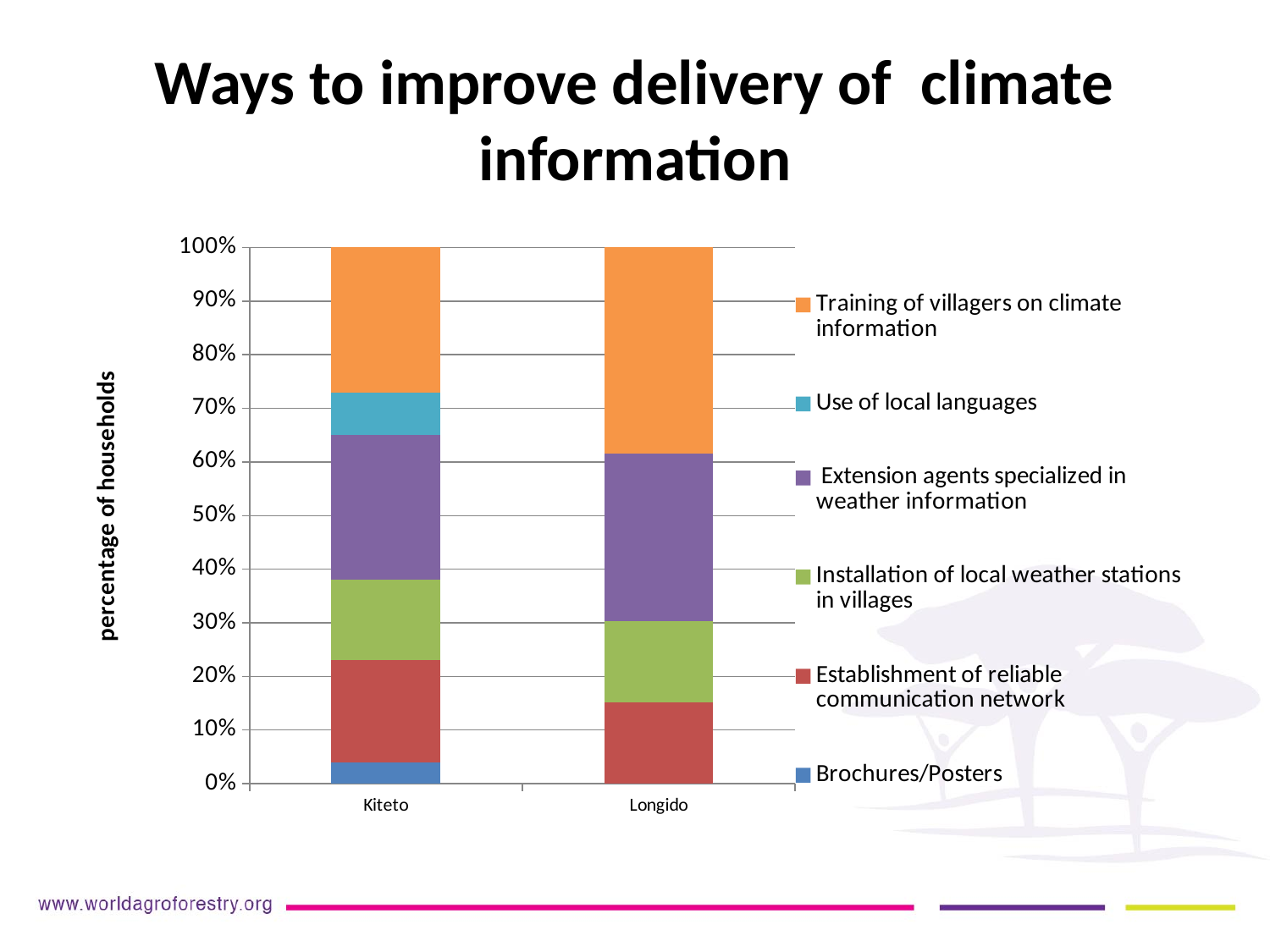
Is the share for Training of villagers on climate information in Longido greater or less than 30%? greater Which series has the largest share in the Longido bar? Training of villagers on climate information What is the label of the vertical axis? percentage of households Which district has the larger share for Training of villagers on climate information, Kiteto or Longido? Longido Which district has the larger share for Use of local languages, Kiteto or Longido? Kiteto How many categories (districts) are shown on the x axis? 2 Is the share for Brochures/Posters in Kiteto greater or less than 10%? less What is the title of the chart? Ways to improve delivery of climate information What is the total height of the Longido stacked bar? 100% How many series does the legend list? 6 Is the share for Extension agents specialized in weather information in Longido greater or less than 20%? greater What kind of chart is shown on the slide? Stacked bar chart